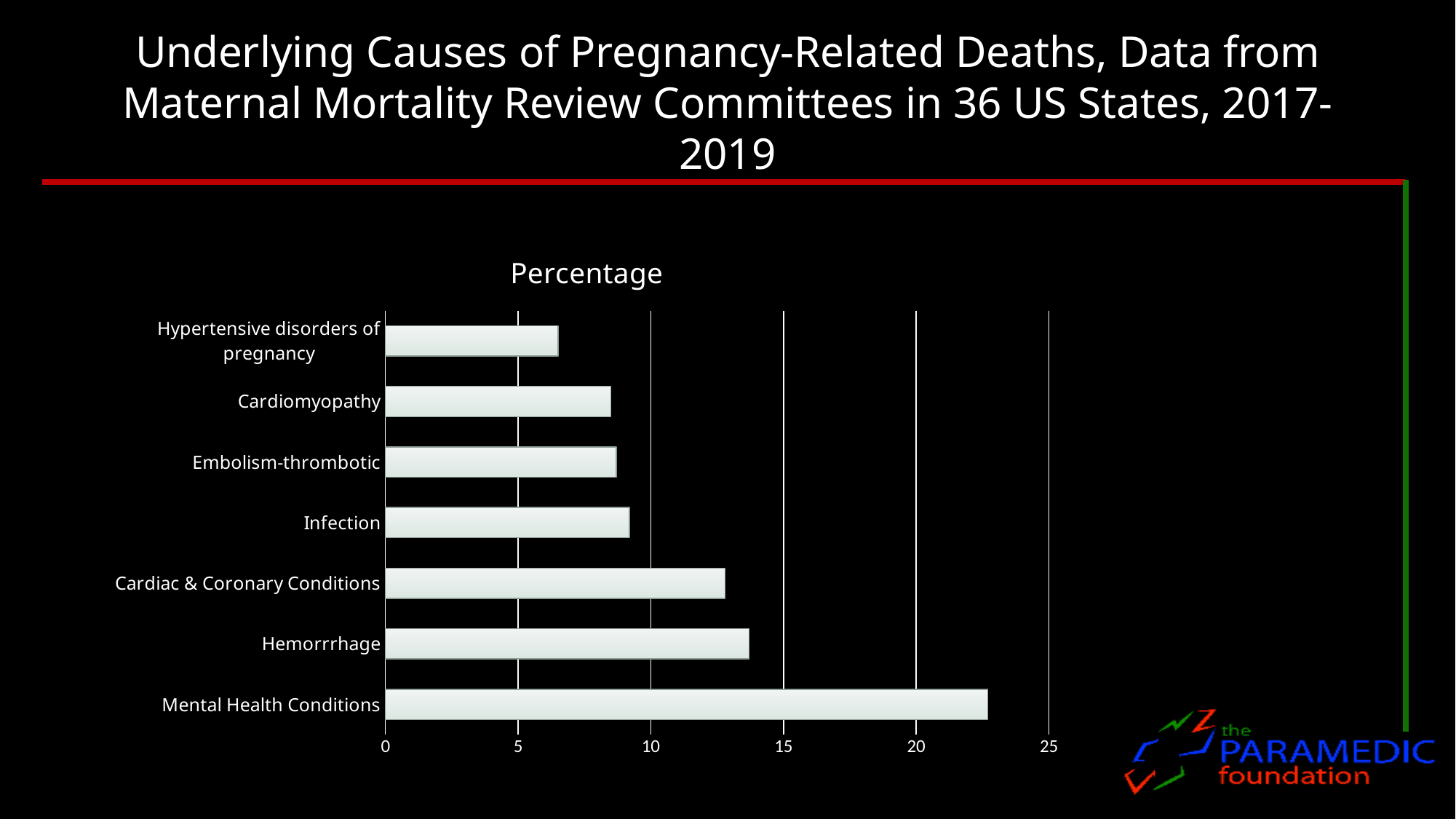
Is the value for Cardiac & Coronary Conditions greater or less than 10? greater Is the value for Hemorrrhage greater or less than 15? less Is the value for Infection greater or less than 10? less How many categories (causes) are plotted in the chart? 7 What is the title shown above the chart? Percentage Which is larger, the value for Cardiac & Coronary Conditions or the value for Infection? Cardiac & Coronary Conditions Which is larger, the value for Mental Health Conditions or the value for Hemorrrhage? Mental Health Conditions Which cause has the highest percentage in the chart? Mental Health Conditions Which cause has the lowest percentage in the chart? Hypertensive disorders of pregnancy What kind of chart is shown on the slide? bar chart